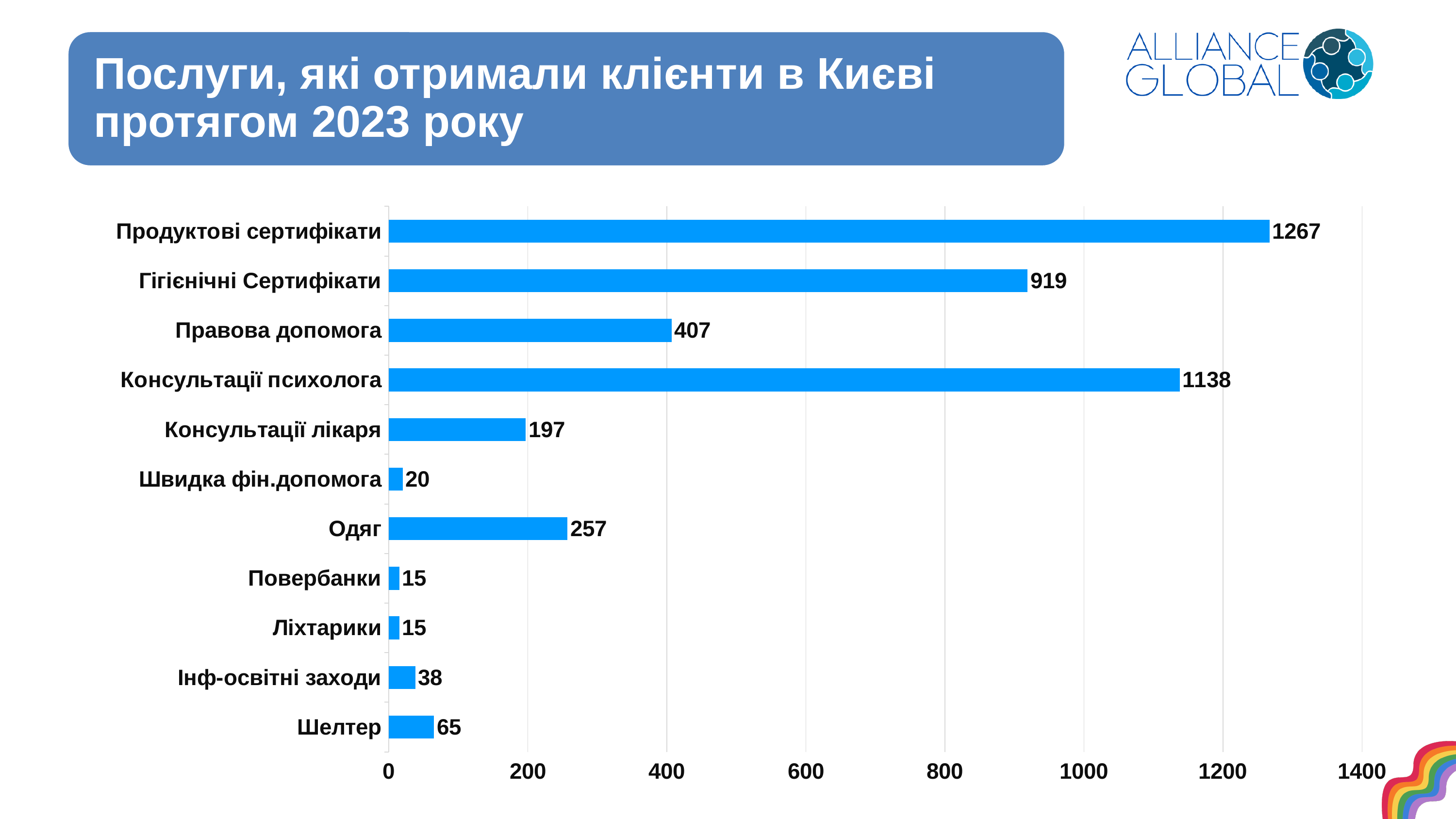
What is the value for Правова допомога? 407 What is the title of the slide? Послуги, які отримали клієнти в Києві протягом 2023 року What is the difference between Продуктові сертифікати and Гігієнічні Сертифікати? 348 What is the value for Продуктові сертифікати? 1267 Which is larger, Консультації психолога or Гігієнічні Сертифікати? Консультації психолога Is the value for Правова допомога greater or less than 400? greater How many categories are shown in the chart? 11 Which category has the highest value? Продуктові сертифікати What is the difference between Одяг and Консультації лікаря? 60 What type of chart is shown on the slide? bar chart What is the value for Шелтер? 65 What is the value for Консультації психолога? 1138